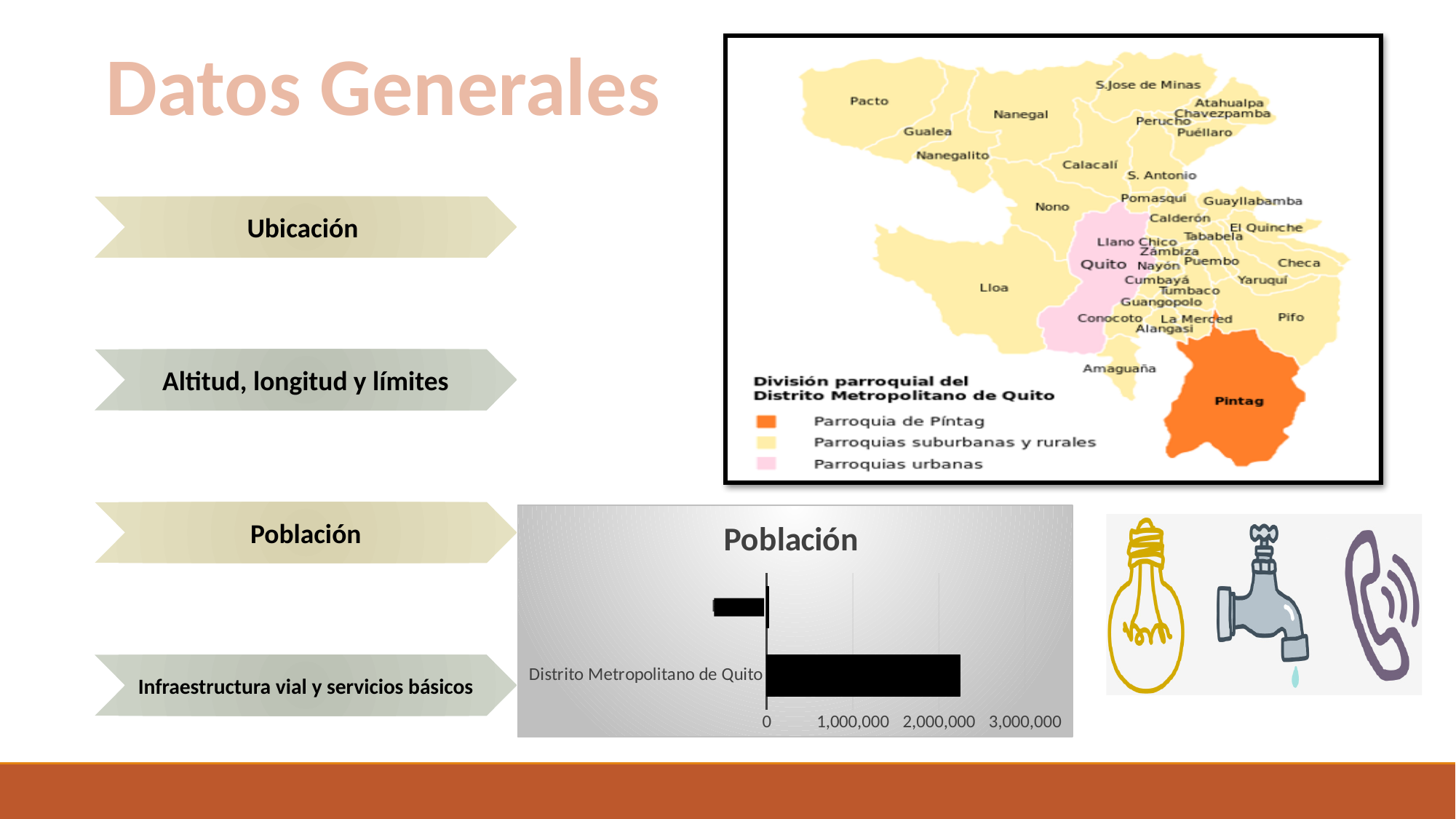
What is the title of the chart at the bottom of the slide? Población What is the highest tick value shown on the x axis of the 'Población' chart? 3,000,000 What kind of chart is the 'Población' chart on the slide? bar chart In the 'Población' chart, is the value for Distrito Metropolitano de Quito greater or less than 2,000,000? greater In the 'Población' chart, is the value for Distrito Metropolitano de Quito greater or less than 1,000,000? greater In the 'Población' chart, which category has the longest bar? Distrito Metropolitano de Quito How many bars are plotted in the 'Población' chart? 2 In the 'Población' chart, is the value for Distrito Metropolitano de Quito greater or less than 3,000,000? less